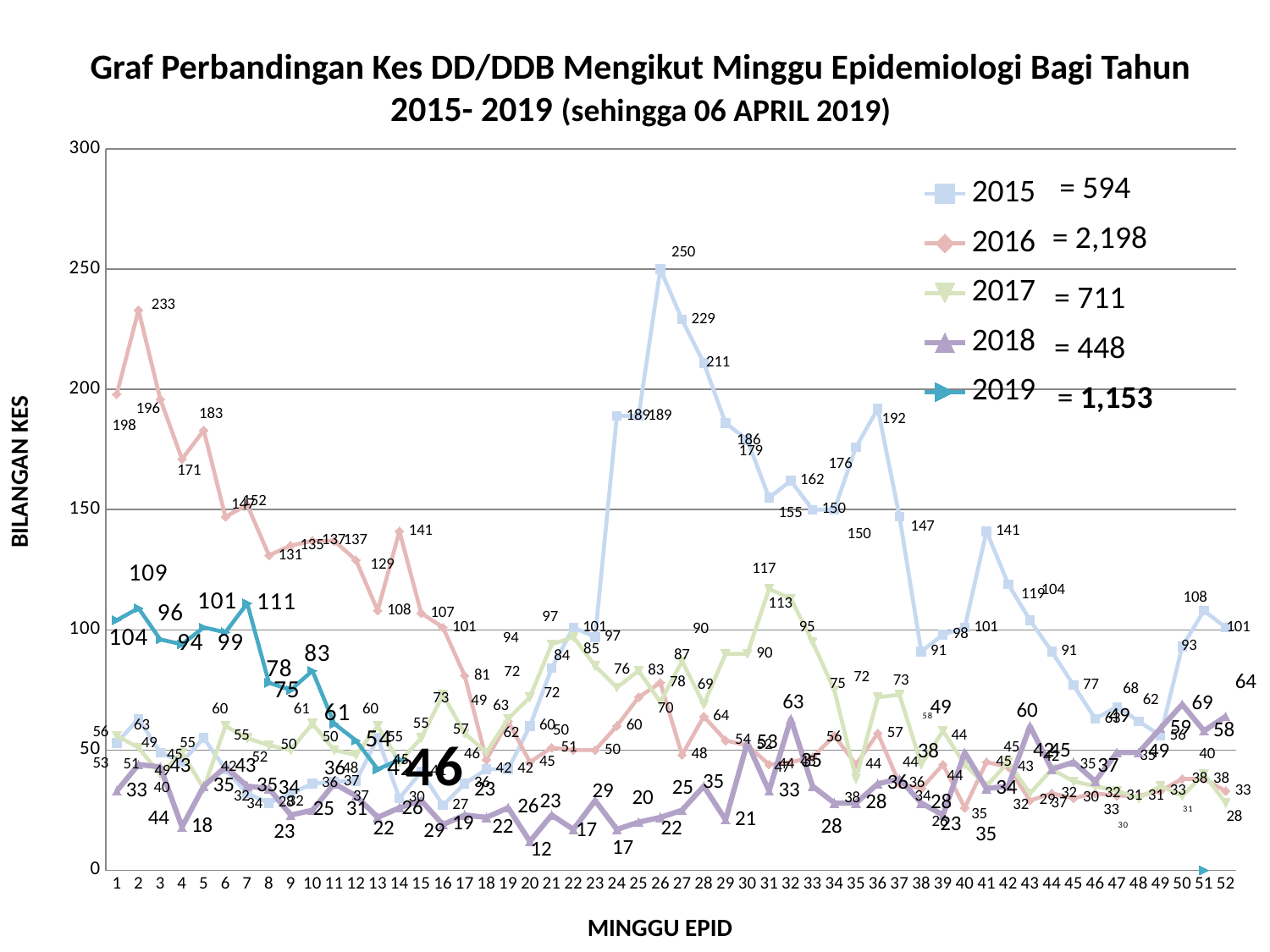
How many epidemiological weeks are shown on the x axis? 52 Which is larger: the 2016 value in week 2 or the 2015 value in week 26? 2015 value in week 26 What is the difference between the 2019 values in week 2 and week 1? 5 Which year has the smallest total shown in the legend? 2018 What type of chart is shown on the slide? Line chart According to the legend, what is the total for 2016? 2,198 According to the legend, what is the total for 2019? 1,153 How many series does the legend list? 5 What is the value for 2019 in week 7? 111 What is the value for 2016 in week 2? 233 What is the highest value plotted for the 2015 series, and in which week does it occur? 250, week 26 What is the label of the x axis? MINGGU EPID